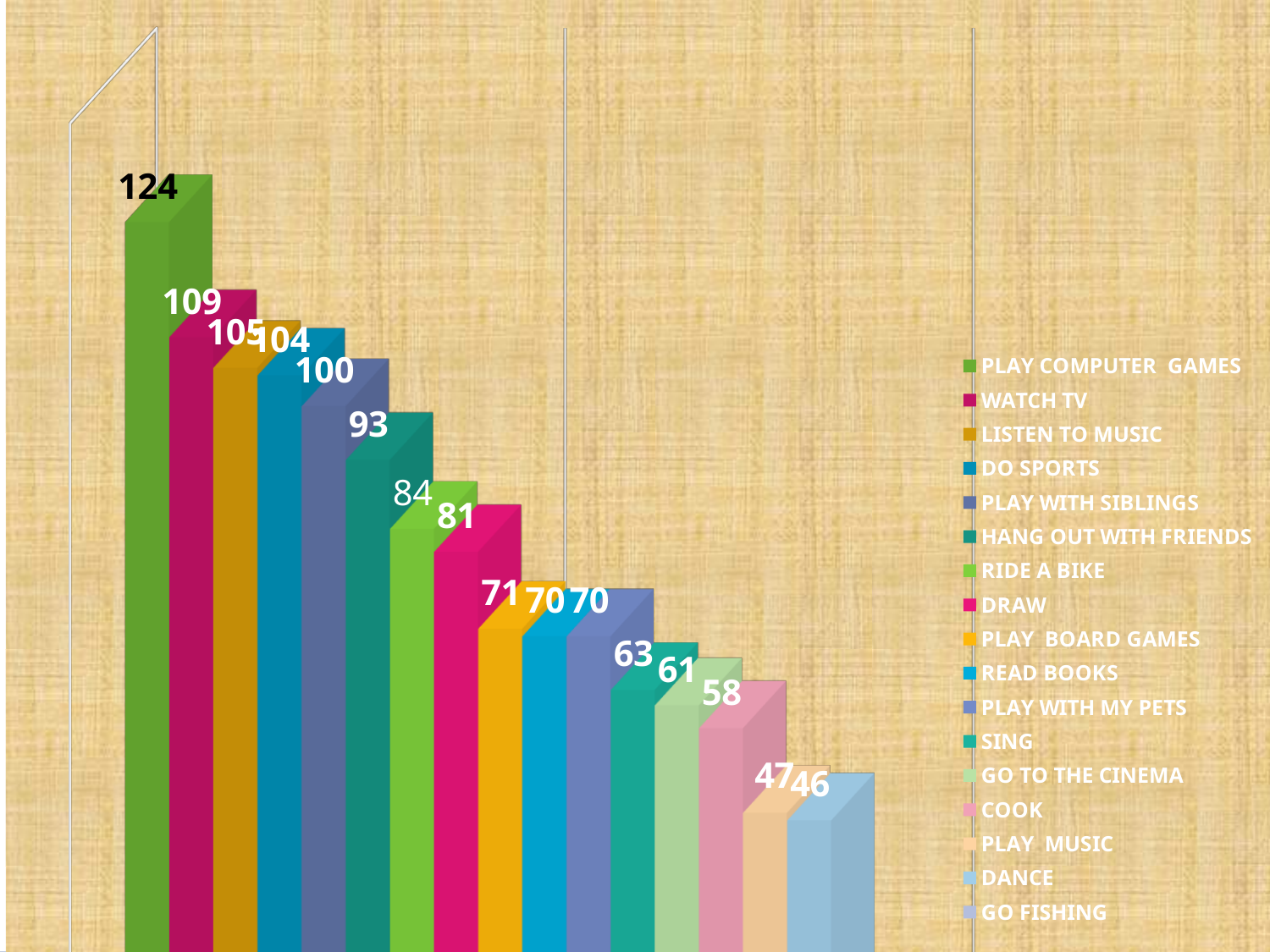
Which is larger, the value for RIDE A BIKE or the value for SING? RIDE A BIKE Which activity has the highest value? PLAY COMPUTER GAMES What is the difference between the values for PLAY COMPUTER GAMES and WATCH TV? 15 What is the value for DRAW? 81 What is the value for PLAY COMPUTER GAMES? 124 Do the bar values rise or fall from left to right? Fall What is the difference between the values for DO SPORTS and PLAY WITH SIBLINGS? 4 What is the value for WATCH TV? 109 How many entries does the legend list? 17 What is the value for HANG OUT WITH FRIENDS? 93 What kind of chart is shown on the slide? Bar chart What is the value for COOK? 58